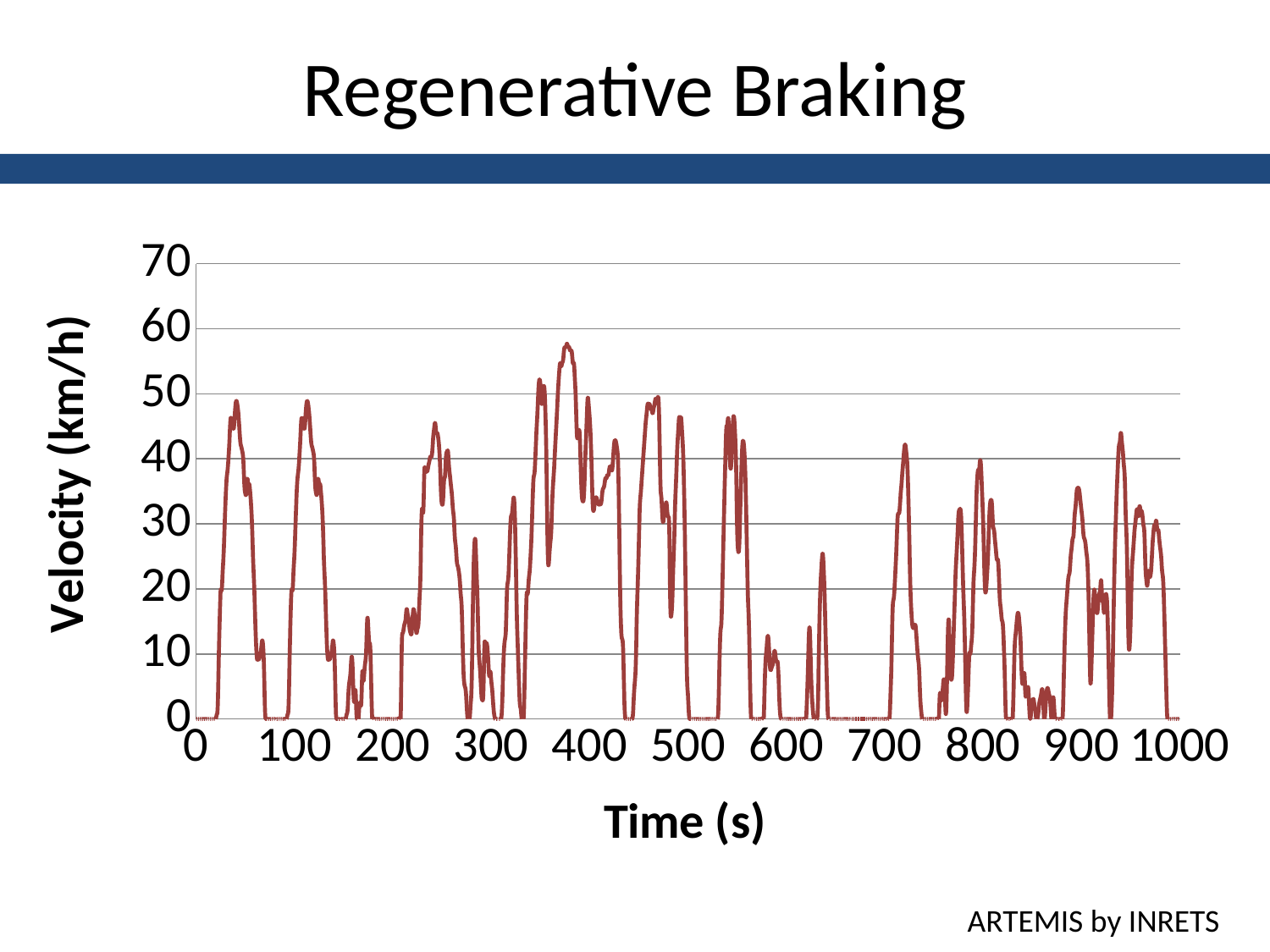
Is the highest velocity reached on the chart greater or less than 60 km/h? less What is the velocity at time 1000 s? 0 Between which two labelled time ticks does the highest velocity peak occur? 300 and 400 What is the highest value shown on the velocity axis? 70 What is the label of the horizontal axis of the chart? Time (s) What kind of chart is shown on the slide? line chart Is the highest velocity reached on the chart greater or less than 50 km/h? greater Is the velocity at 680 s greater or less than 10 km/h? less What is the label of the vertical axis of the chart? Velocity (km/h) What is the velocity at time 0 s? 0